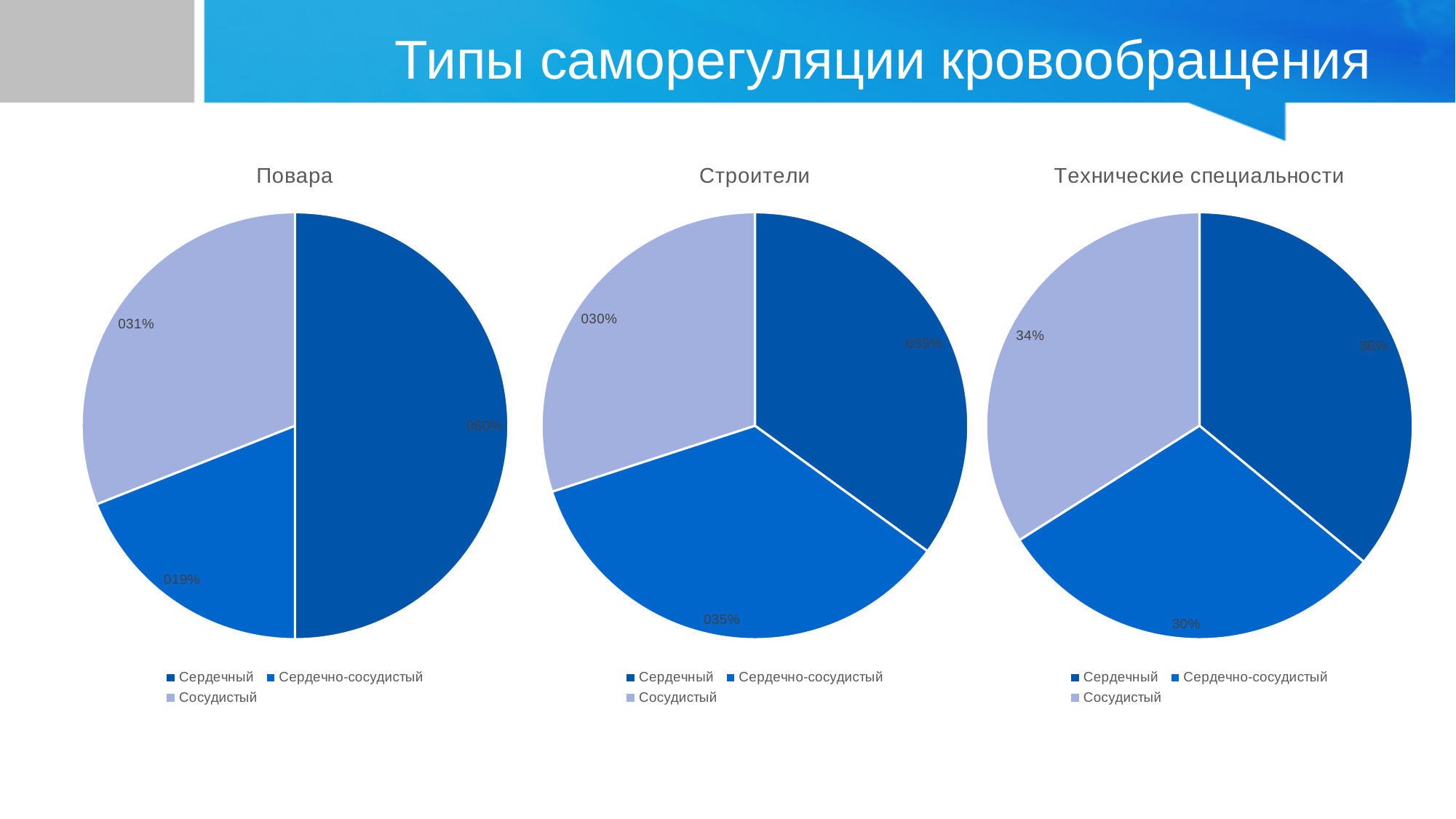
In the Повара pie chart, which category has the largest slice? Сердечный In the Технические специальности pie chart, what is the value for Сосудистый? 34% How many slices does the Строители pie chart have? 3 In the Строители pie chart, which is larger, Сердечный or Сосудистый? Сердечный In the Технические специальности pie chart, what is the value for Сердечный? 36% In the Повара pie chart, what is the value for Сердечный? 050% What type of chart is used for Технические специальности? Pie chart In the Повара pie chart, what is the difference between the Сердечный and Сосудистый values? 19% In the Повара pie chart, which category has the smallest slice? Сердечно-сосудистый In the Строители pie chart, what is the value for Сосудистый? 030% In the Технические специальности pie chart, which category has the smallest slice? Сердечно-сосудистый In the Повара pie chart, what is the value for Сердечно-сосудистый? 019%